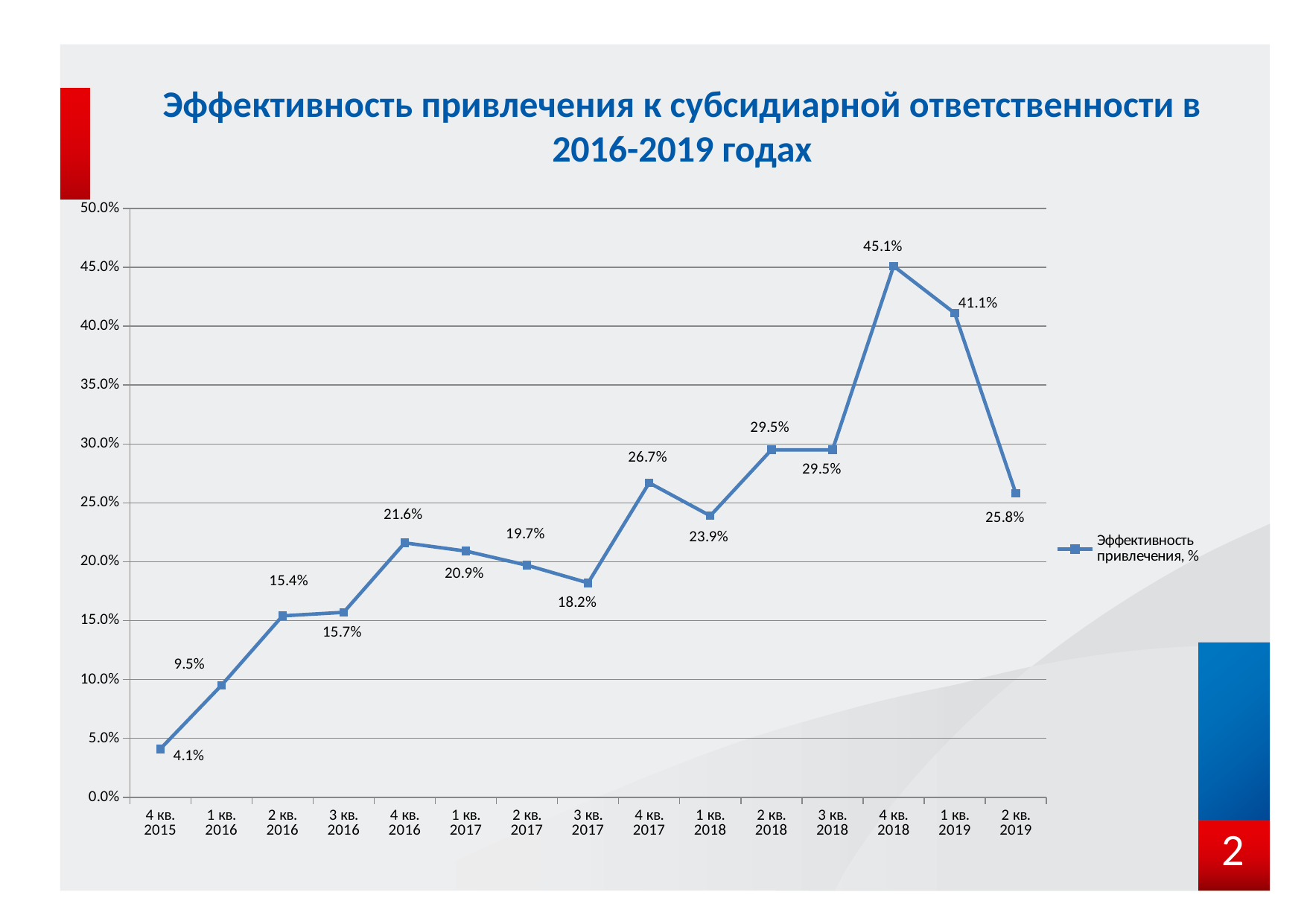
Which quarter has the highest value? 4 кв. 2018 Which quarter has the lowest value? 4 кв. 2015 How many quarters are plotted on the x axis? 15 Which is larger, the value for 4 кв. 2017 or the value for 1 кв. 2018? 4 кв. 2017 How many series does the legend list? 1 What is the value for 2 кв. 2019? 25.8% What is the legend entry for the plotted series? Эффективность привлечения, % What is the value for 1 кв. 2016? 9.5% Is the value for 4 кв. 2016 greater or less than 20.0%? greater What is the difference between the values for 4 кв. 2018 and 1 кв. 2019? 4.0% What kind of chart is shown on the slide? line chart What is the value for 4 кв. 2018? 45.1%